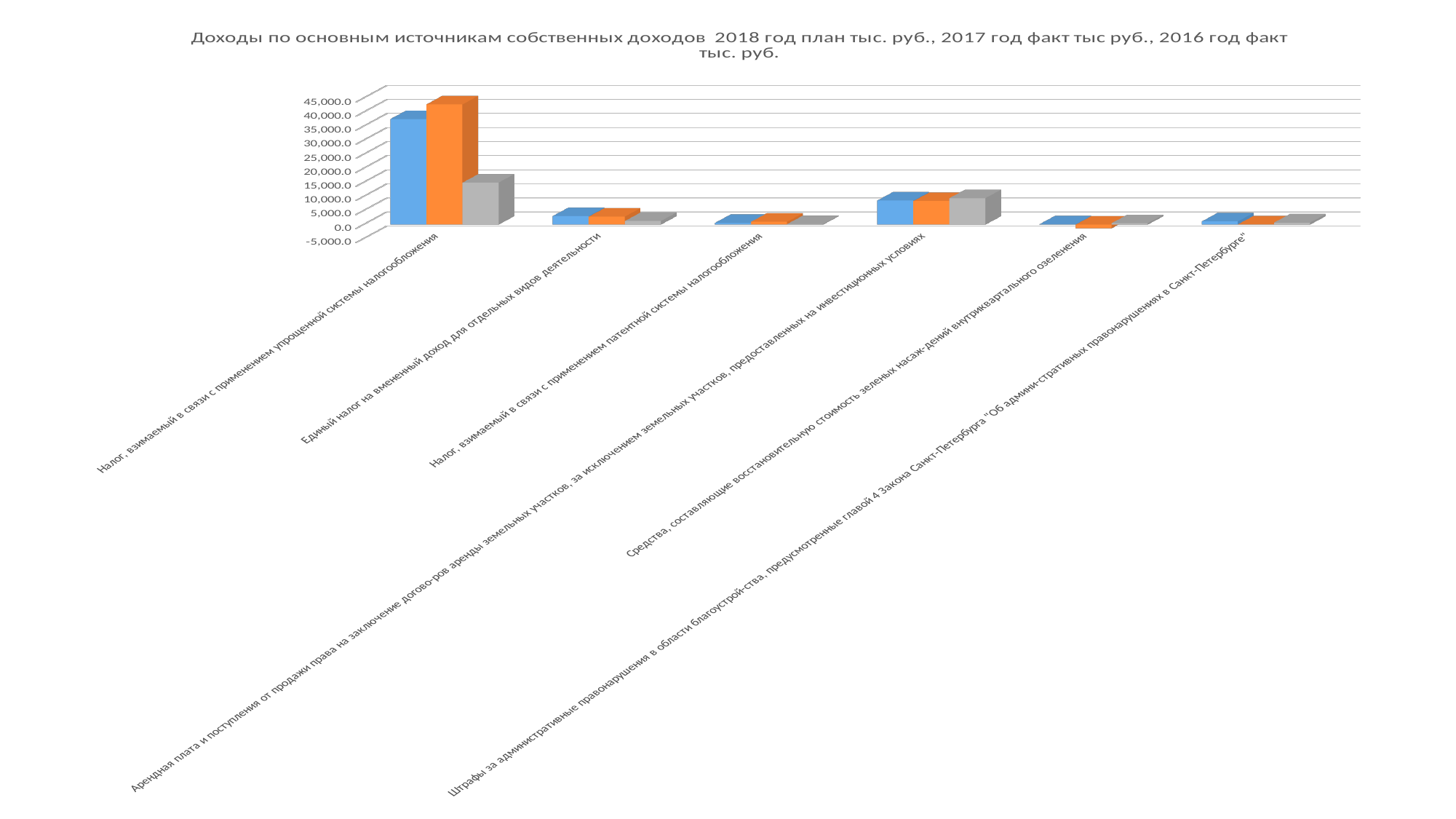
What is the lowest value shown on the vertical axis of the chart? -5,000.0 For 'Налог, взимаемый в связи с применением упрощенной системы налогообложения', which bar is taller, the blue one or the gray one? The blue one How many categories are plotted along the x axis of the chart? 6 Which category has the tallest bars in the chart? Налог, взимаемый в связи с применением упрощенной системы налогообложения How many differently coloured bar series are plotted for each category? 3 Is the value of the orange bar for 'Средства, составляющие восстановительную стоимость зеленых насаж-дений внутриквартального озеленения' greater or less than 0.0? less Is the value of the orange bar for 'Налог, взимаемый в связи с применением упрощенной системы налогообложения' greater or less than 40,000.0? greater Is the value of the blue bar for 'Арендная плата и поступления от продажи права на заключение догово-ров аренды земельных участков, за исключением земельных участков, предоставленных на инвестиционных условиях' greater or less than 5,000.0? greater For 'Налог, взимаемый в связи с применением упрощенной системы налогообложения', which bar is taller, the blue one or the orange one? The orange one What kind of chart is shown on the slide? Bar chart